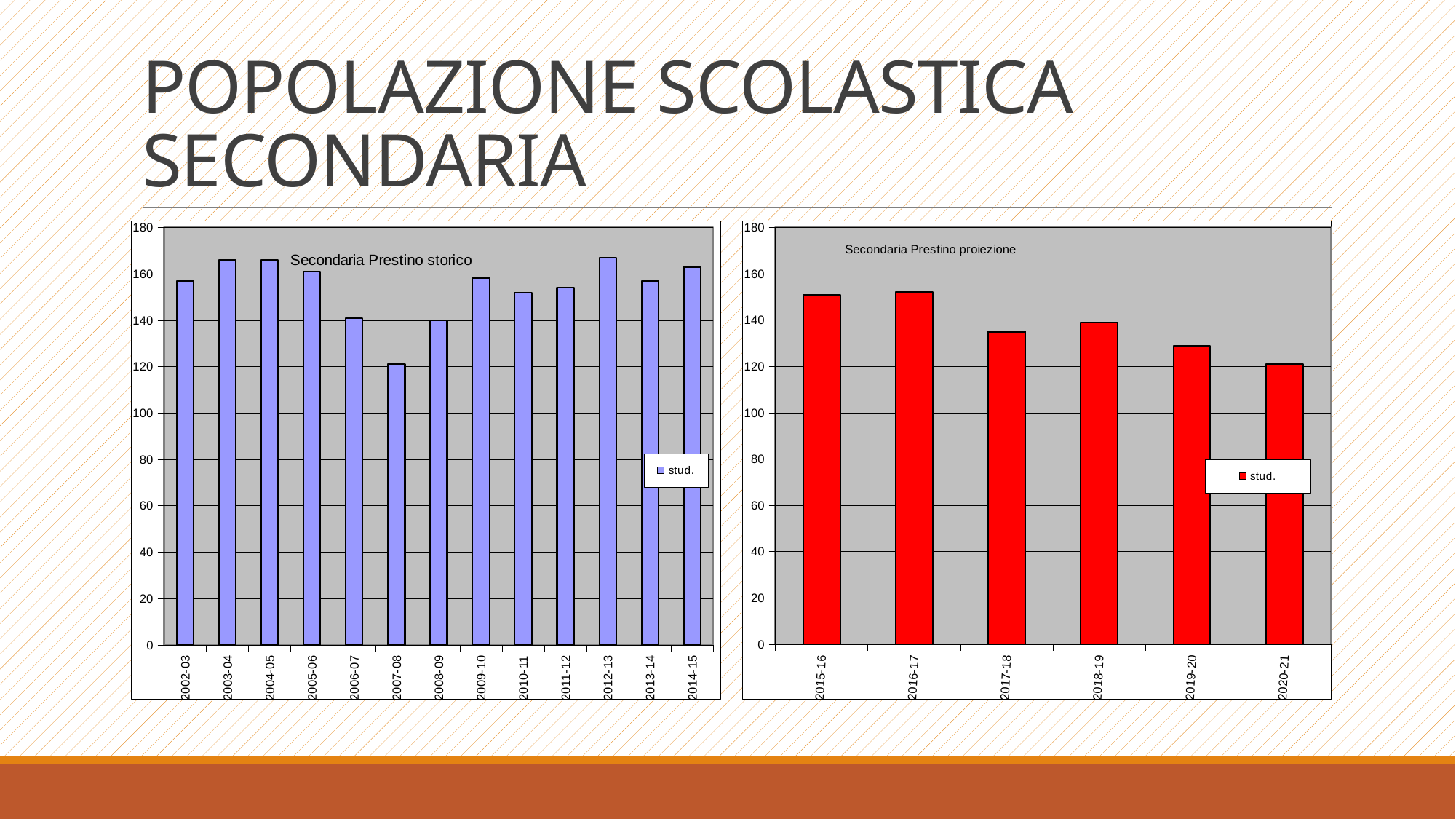
In the 'Secondaria Prestino storico' chart, is the value for 2003-04 greater or less than 160? greater In the 'Secondaria Prestino proiezione' chart, is the value for 2019-20 greater or less than 140? less In the 'Secondaria Prestino storico' chart, which school year has the lowest value? 2007-08 How many series does the legend of the 'Secondaria Prestino proiezione' chart list? 1 In the 'Secondaria Prestino storico' chart, is the value for 2007-08 greater or less than 140? less In the 'Secondaria Prestino storico' chart, which is larger, the value for 2007-08 or the value for 2012-13? 2012-13 In the 'Secondaria Prestino proiezione' chart, do the values generally rise or fall from 2015-16 to 2020-21? fall How many school years are shown on the x axis of the 'Secondaria Prestino proiezione' chart? 6 How many school years are shown on the x axis of the 'Secondaria Prestino storico' chart? 13 What kind of chart is the 'Secondaria Prestino storico' chart on the left? bar chart In the 'Secondaria Prestino proiezione' chart, which school year has the lowest value? 2020-21